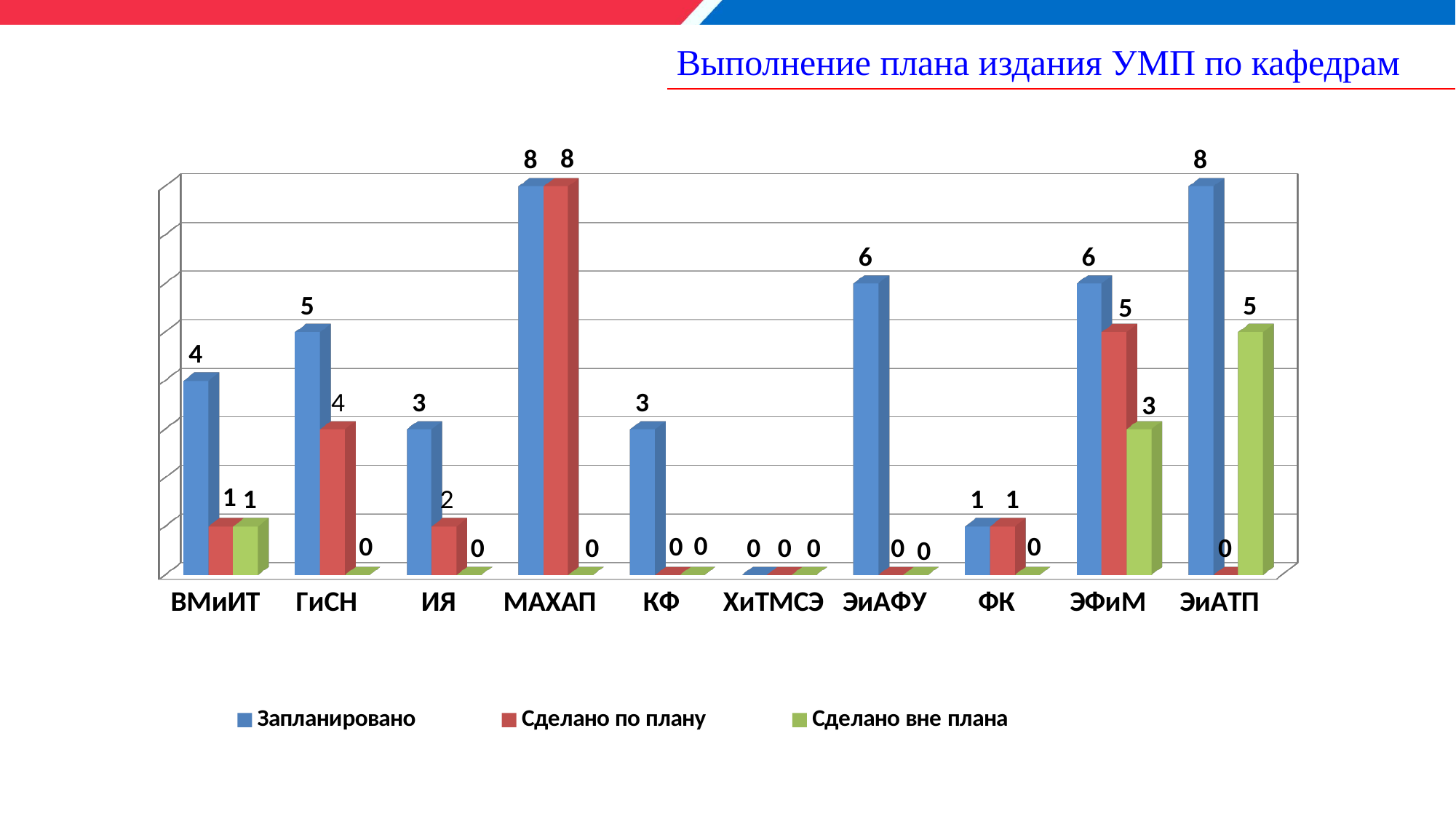
How many series does the legend list? 3 Which is larger for ИЯ: Запланировано or Сделано по плану? Запланировано What is the value of Запланировано for ГиСН? 5 How many departments (categories) are shown on the x axis? 10 What type of chart is shown on the slide? bar chart What is the value of Сделано вне плана for ЭиАТП? 5 Which department has the highest value for Сделано по плану? МАХАП What is the value of Сделано по плану for ЭФиМ? 5 What is the title of the slide? Выполнение плана издания УМП по кафедрам What is the value of Запланировано for ХиТМСЭ? 0 Which department has the highest value for Сделано вне плана? ЭиАТП What is the difference between Запланировано and Сделано по плану for ЭиАФУ? 6